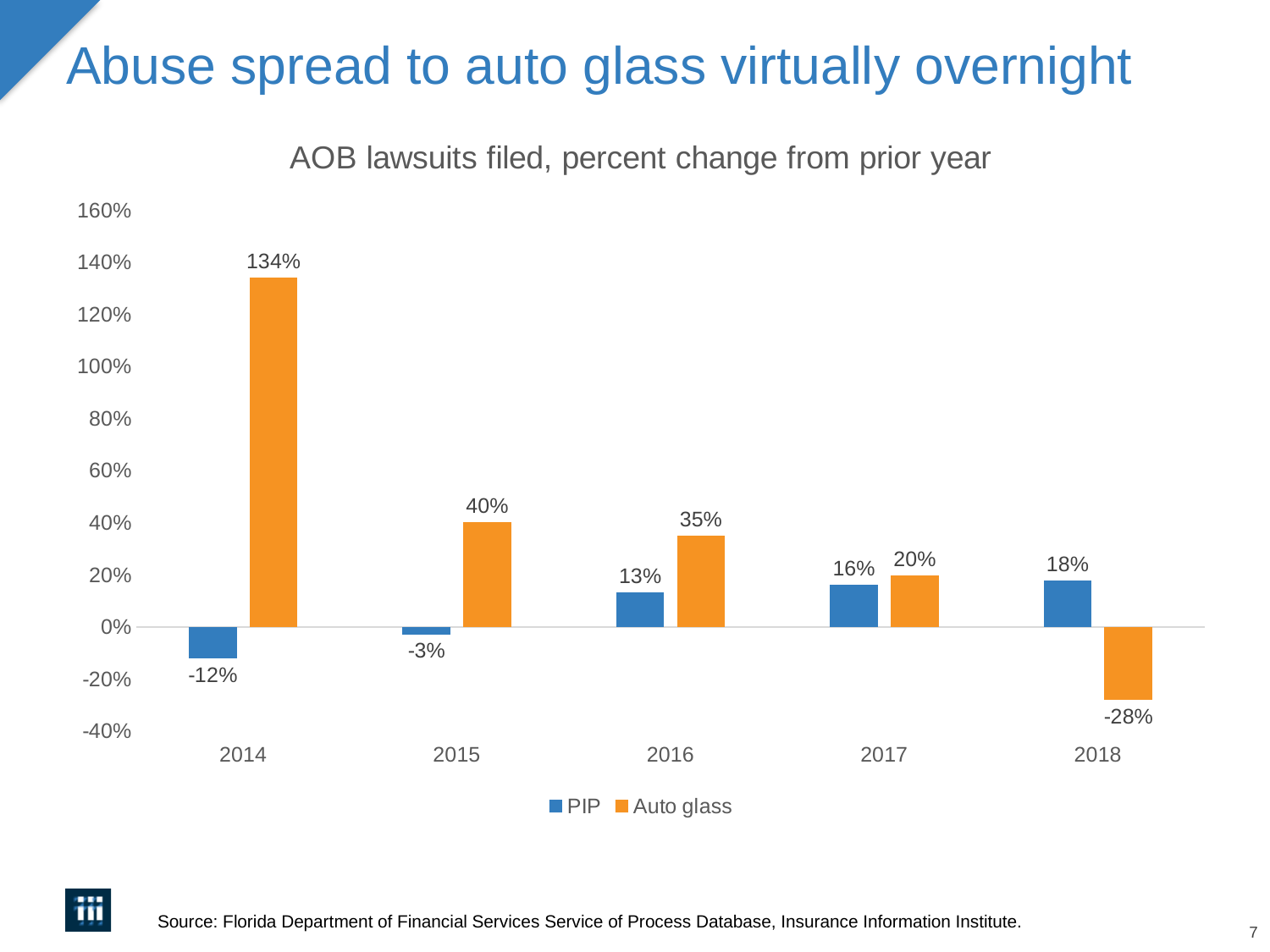
How many series does the legend list? 2 Which year has the lowest PIP value? 2014 What is the Auto glass value for 2014? 134% In 2017, which series has the larger value, PIP or Auto glass? Auto glass What is the PIP value for 2015? -3% How many years are shown on the x axis? 5 What is the Auto glass value for 2018? -28% What is the PIP value for 2018? 18% What kind of chart is shown on the slide? Bar chart What is the difference between the Auto glass and PIP values in 2016? 22% Which year has the highest Auto glass value? 2014 What is the title of the chart? AOB lawsuits filed, percent change from prior year